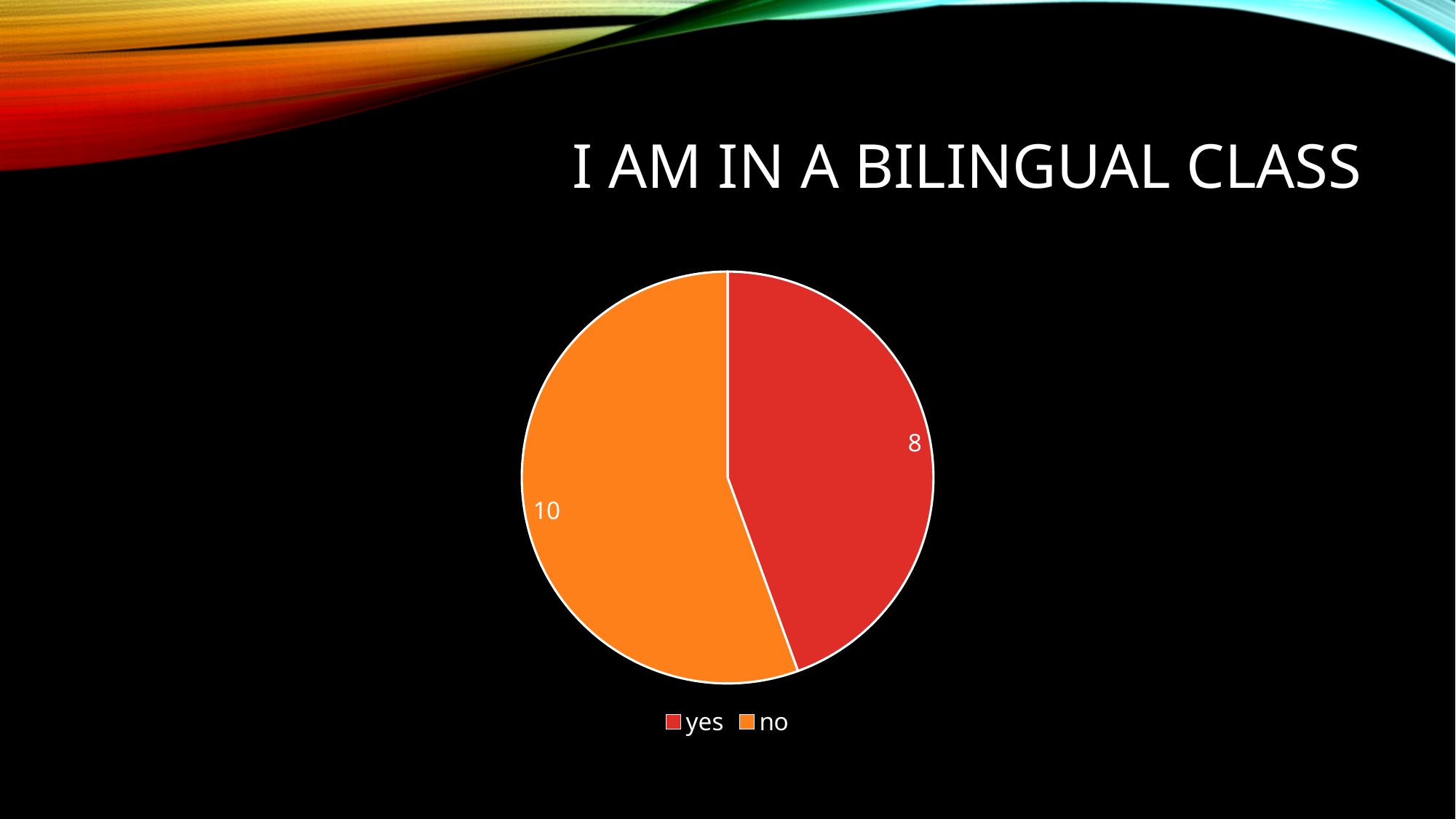
What is the value for "no"? 10 Which category has the smallest slice? yes What is the title of the slide containing the chart? I AM IN A BILINGUAL CLASS What is the difference between the values for "no" and "yes"? 2 How many entries does the legend list? 2 Which category has the largest slice? no What kind of chart is shown on the slide? pie chart Which is larger, the value for "yes" or the value for "no"? no What colour is the "no" slice? orange What is the total of all slices in the pie chart? 18 What is the value for "yes"? 8 How many slices does the pie chart have? 2